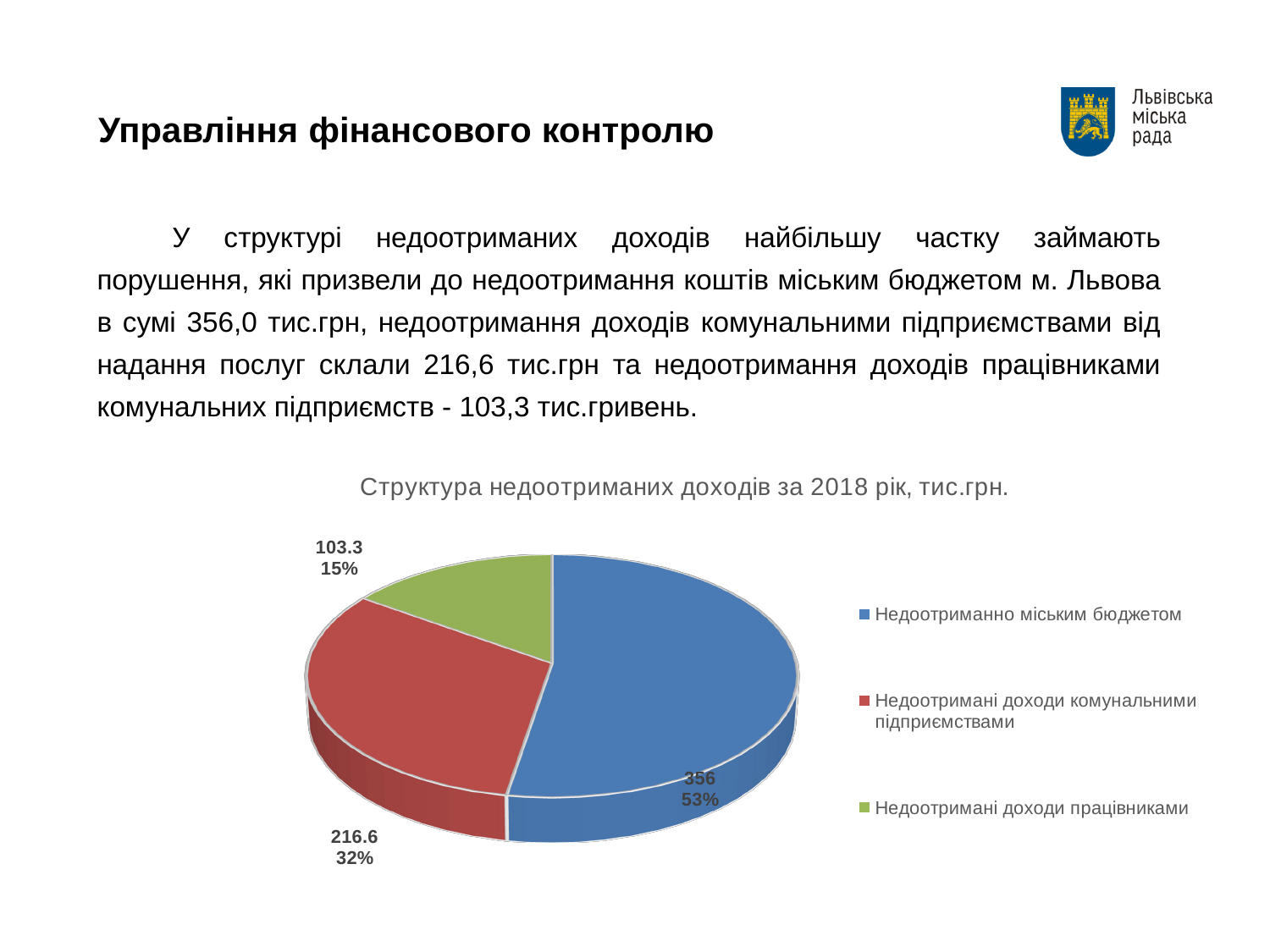
Which category has the largest slice? Недоотриманно міським бюджетом Which colour represents 'Недоотримані доходи комунальними підприємствами' in the legend? red Which category has the smallest slice? Недоотримані доходи працівниками What kind of chart is shown on the slide? pie chart What share of the pie does 'Недоотримані доходи працівниками' take? 15% What is the value for 'Недоотримані доходи комунальними підприємствами'? 216.6 What share of the pie does 'Недоотриманно міським бюджетом' take? 53% What is the title of the chart? Структура недоотриманих доходів за 2018 рік, тис.грн. What is the value for 'Недоотриманно міським бюджетом'? 356 What is the difference between the values for 'Недоотриманно міським бюджетом' and 'Недоотримані доходи комунальними підприємствами'? 139.4 How many slices does the pie chart have? 3 What is the value for 'Недоотримані доходи працівниками'? 103.3